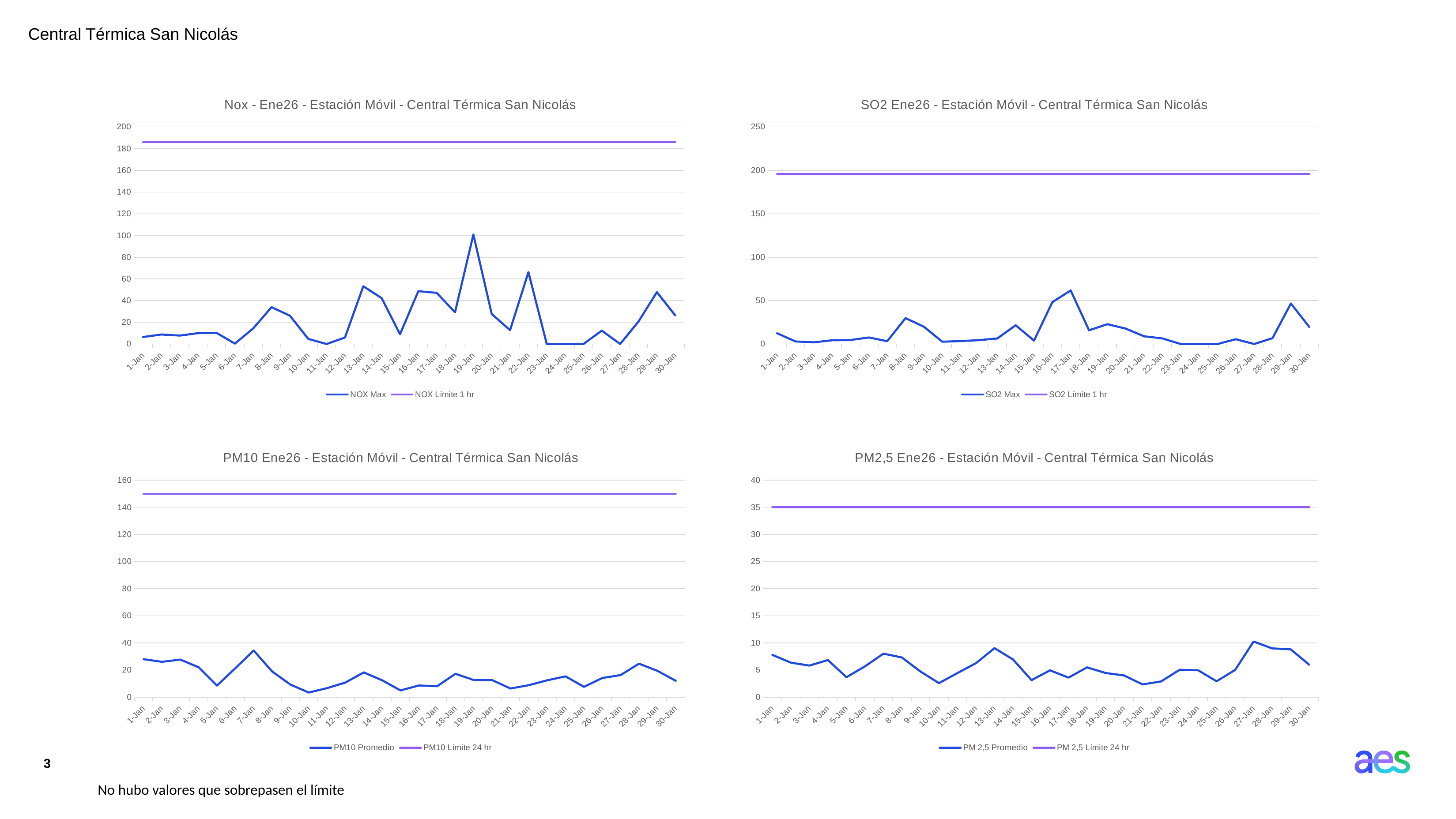
How many dates are plotted along the x axis of the 'PM10 Ene26 - Estación Móvil - Central Térmica San Nicolás' chart? 30 In the 'PM2,5 Ene26' chart, on which date does PM 2,5 Promedio reach its highest value? 27-Jan What are the two legend entries of the 'PM10 Ene26 - Estación Móvil - Central Térmica San Nicolás' chart? PM10 Promedio and PM10 Límite 24 hr In the 'PM2,5 Ene26' chart, what value does the PM 2,5 Límite 24 hr line sit at? 35 In the 'Nox - Ene26' chart, on which date does NOX Max reach its highest value? 19-Jan In the 'SO2 Ene26' chart, on which date does SO2 Max reach its highest value? 17-Jan How many series does the legend of the 'SO2 Ene26 - Estación Móvil - Central Térmica San Nicolás' chart list? 2 In the 'SO2 Ene26' chart, is the SO2 Max value for 17-Jan greater or less than 50? greater In the 'Nox - Ene26' chart, which date has the larger NOX Max value, 13-Jan or 6-Jan? 13-Jan In the 'Nox - Ene26' chart, is the NOX Max value for 19-Jan greater or less than 80? greater What kind of chart is the 'Nox - Ene26 - Estación Móvil - Central Térmica San Nicolás' chart? Line chart